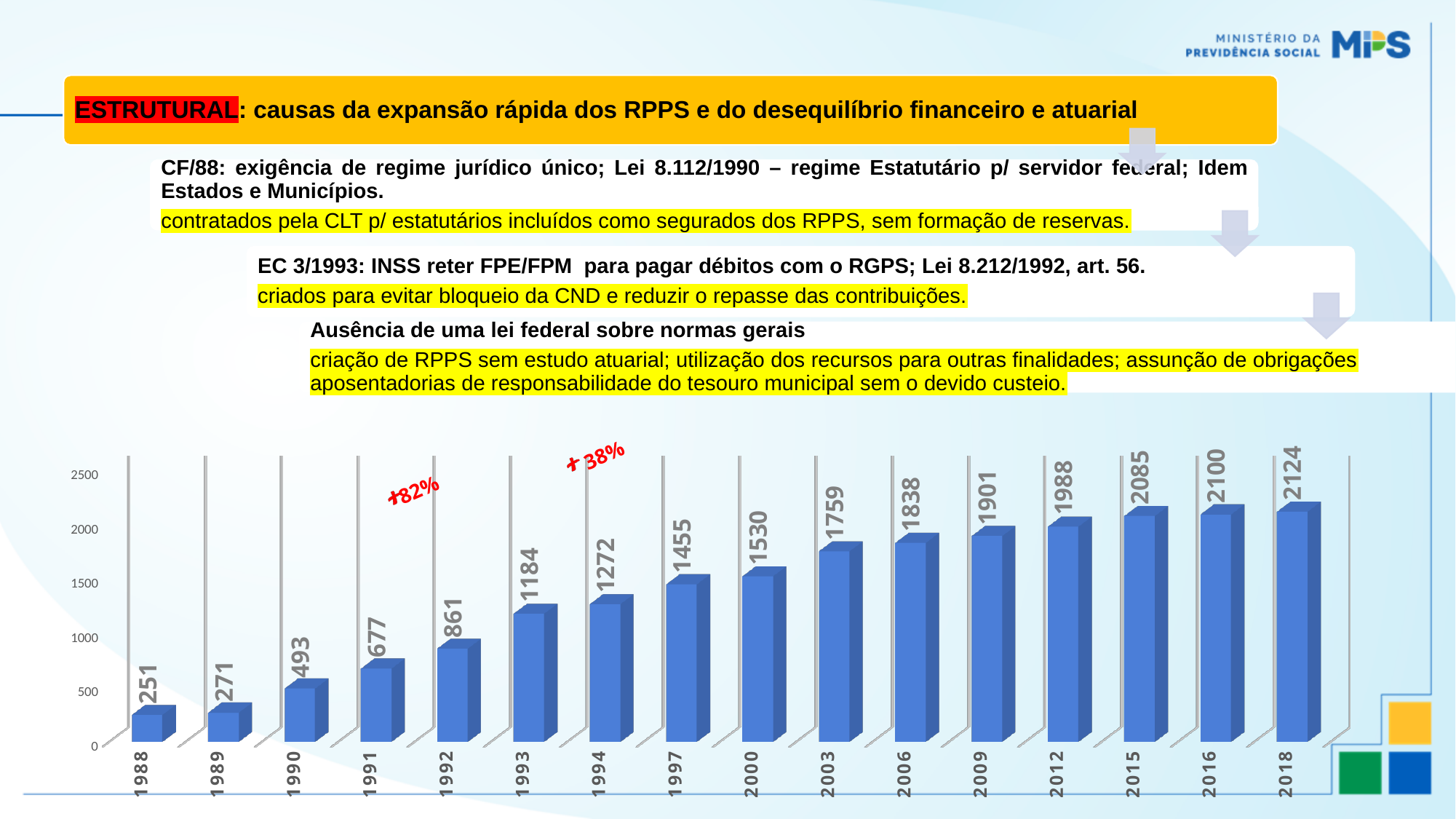
Do the values rise or fall from 1988 to 2018? rise What is the difference between the values for 1993 and 1992? 323 What kind of chart is shown on the slide? bar chart Which year has the lowest value in the bar chart? 1988 What is the value shown for 2018 in the bar chart? 2124 What is the value shown for 1988 in the bar chart? 251 How many years are shown on the x axis of the bar chart? 16 What is the difference between the values for 2018 and 1988? 1873 Is the value for 2003 greater or less than 1500? greater Which year has the highest value in the bar chart? 2018 Which is larger, the value for 1997 or the value for 2000? 2000 What is the value shown for 1993 in the bar chart? 1184